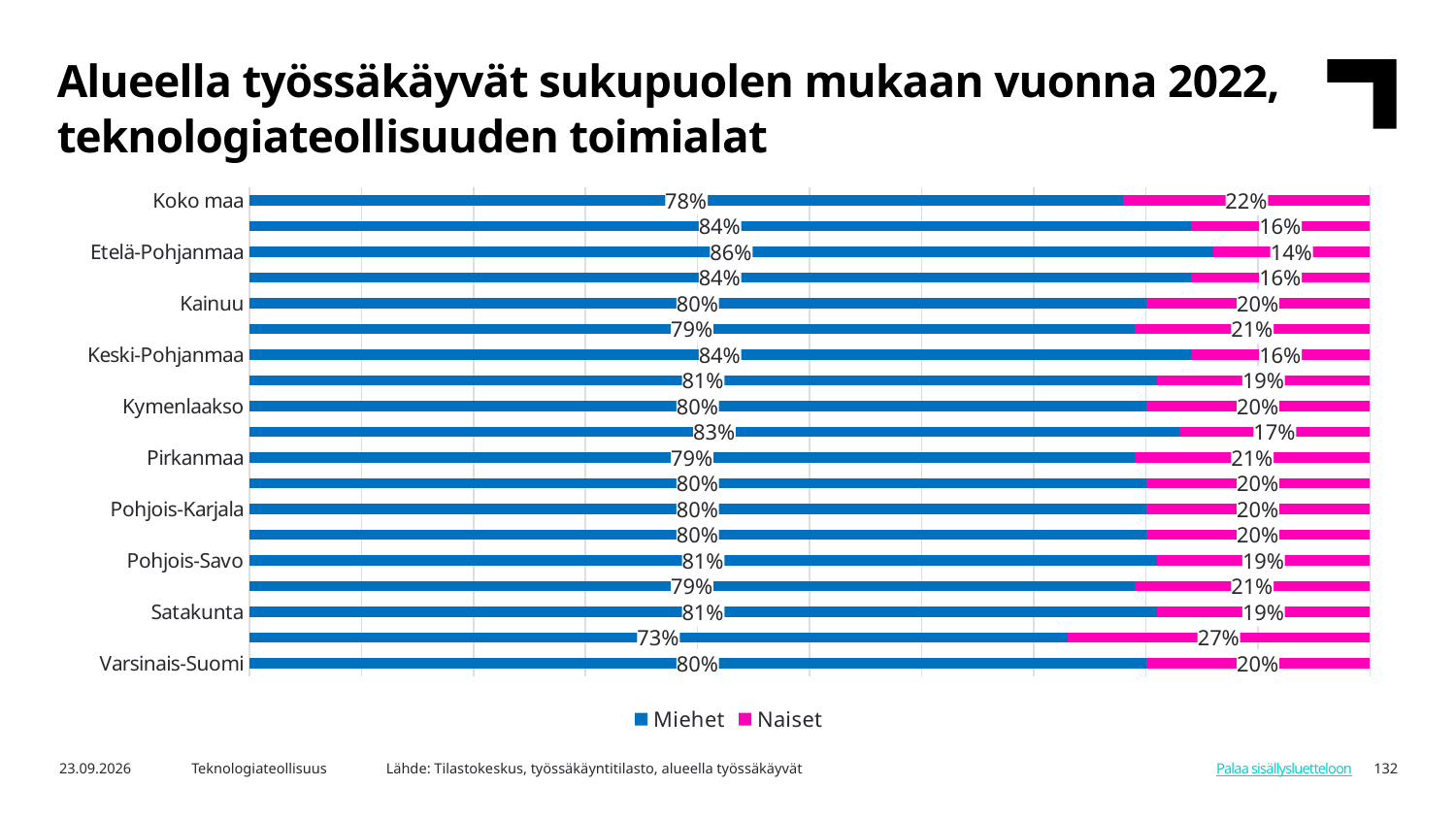
What is the Miehet value for Keski-Pohjanmaa? 84% Which labelled region has the highest Miehet share? Etelä-Pohjanmaa What is the Naiset value for Pirkanmaa? 21% What is the lowest Miehet value shown on the chart? 73% How many bars are plotted on the chart? 19 What kind of chart is shown on the slide? Stacked bar chart What is the difference between the Miehet values for Etelä-Pohjanmaa and Koko maa? 8 percentage points What is the Naiset value for Etelä-Pohjanmaa? 14% Which has a larger Naiset share, Koko maa or Pohjois-Savo? Koko maa What is the Miehet value for Koko maa? 78% What is the total of the stacked bar for Koko maa? 100% How many series does the legend list? 2